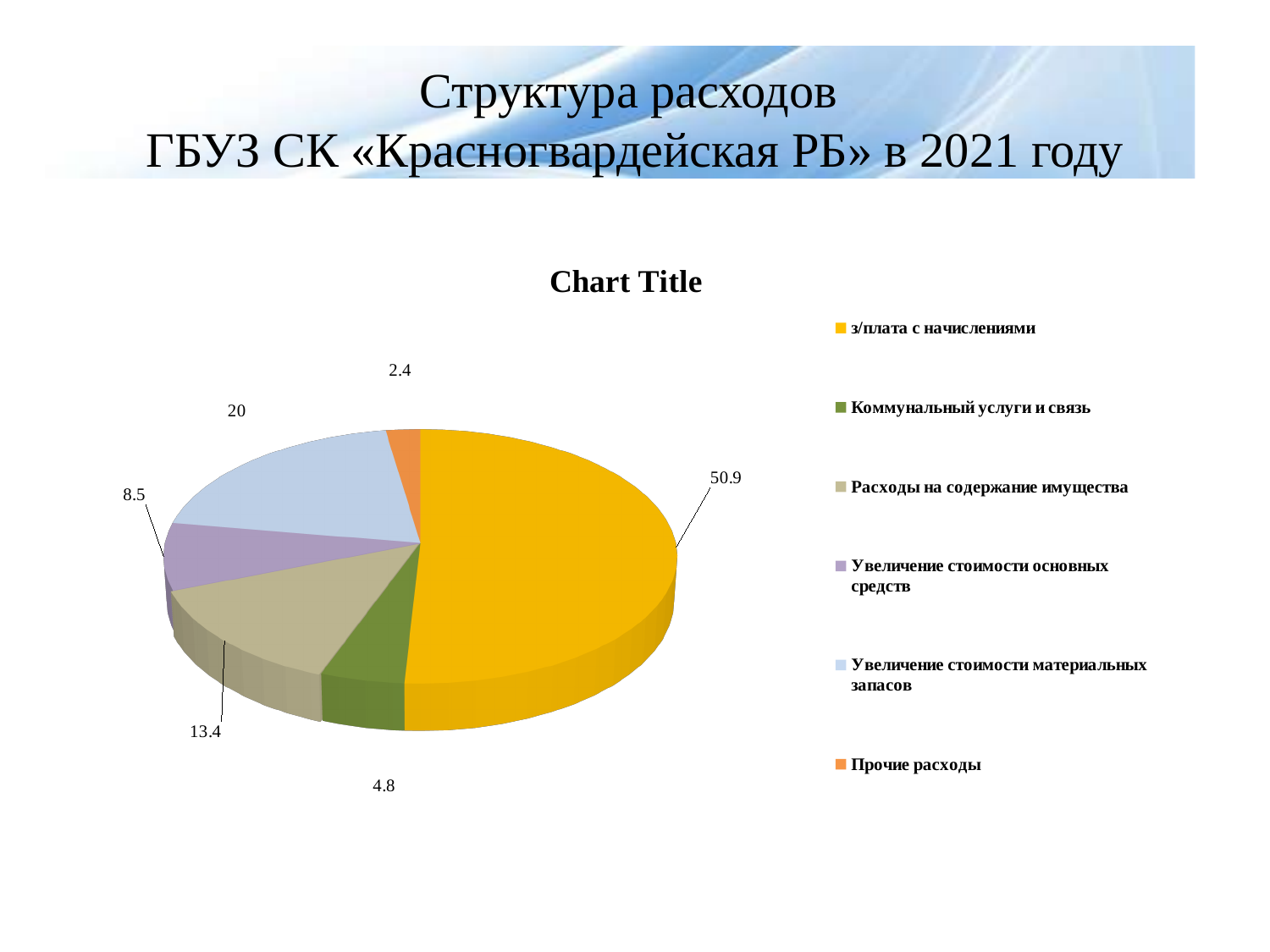
What is the value for Прочие расходы? 2.4 Which category has the largest slice of the pie? з/плата с начислениями How many categories does the legend list? 6 What is the value for Увеличение стоимости основных средств? 8.5 What kind of chart is shown on the slide? pie chart What is the value for з/плата с начислениями? 50.9 Which is larger: Расходы на содержание имущества or Увеличение стоимости основных средств? Расходы на содержание имущества What is the difference between the values for з/плата с начислениями and Увеличение стоимости материальных запасов? 30.9 Which category has the smallest slice of the pie? Прочие расходы What is the value for Увеличение стоимости материальных запасов? 20 What is the value for Коммунальный услуги и связь? 4.8 What is the value for Расходы на содержание имущества? 13.4